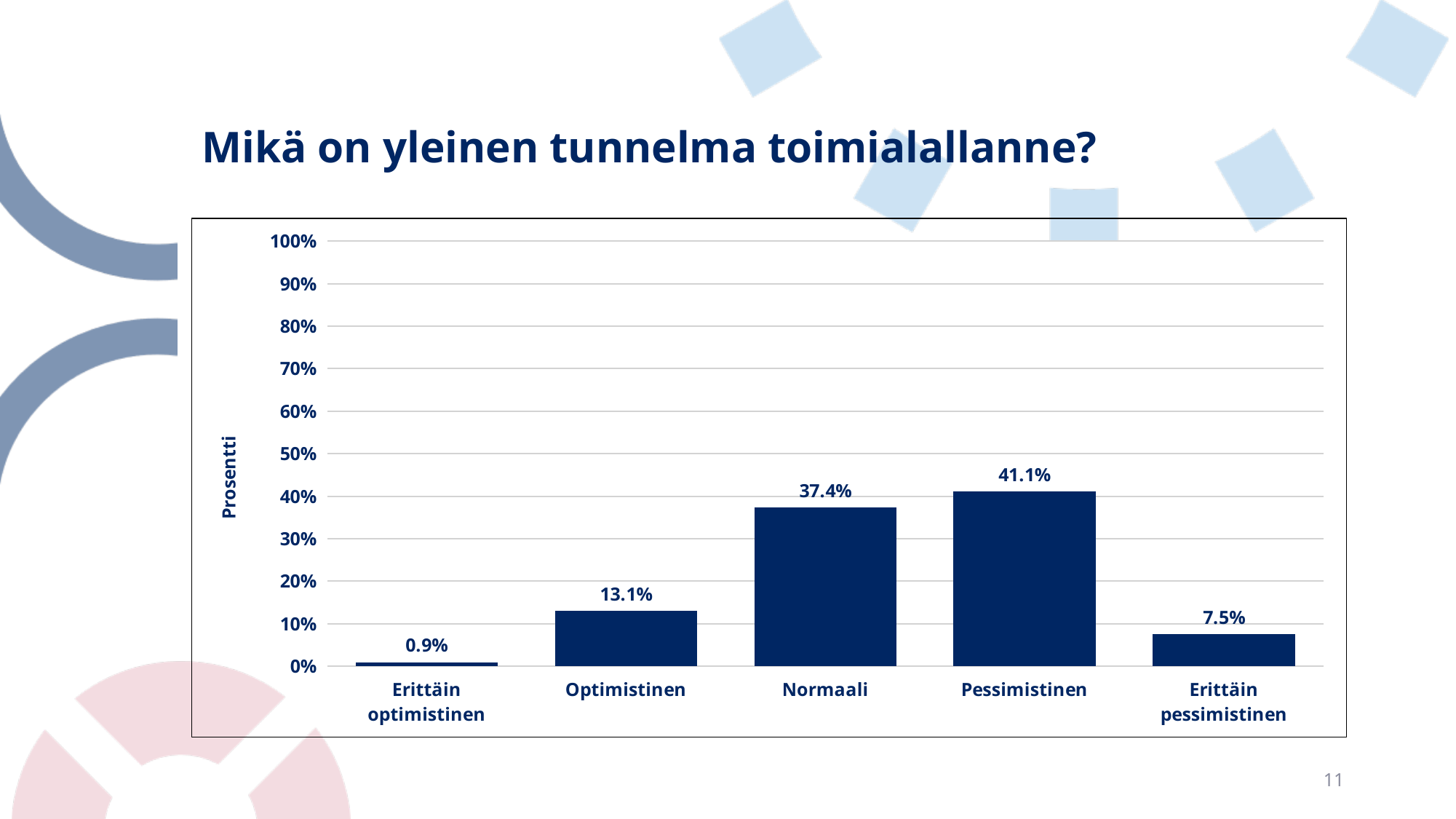
What is the value for Erittäin pessimistinen? 7.5% What kind of chart is shown on the slide? bar chart What is the value for Normaali? 37.4% Which category has the lowest value? Erittäin optimistinen Is the value for Pessimistinen greater or less than 40%? greater How many categories are shown on the x axis? 5 Which is larger, the value for Optimistinen or the value for Erittäin pessimistinen? Optimistinen Which category has the highest value? Pessimistinen What is the difference between the values for Pessimistinen and Normaali? 3.7% What is the value for Erittäin optimistinen? 0.9% What is the label of the vertical axis? Prosentti What is the difference between the values for Optimistinen and Erittäin pessimistinen? 5.6%